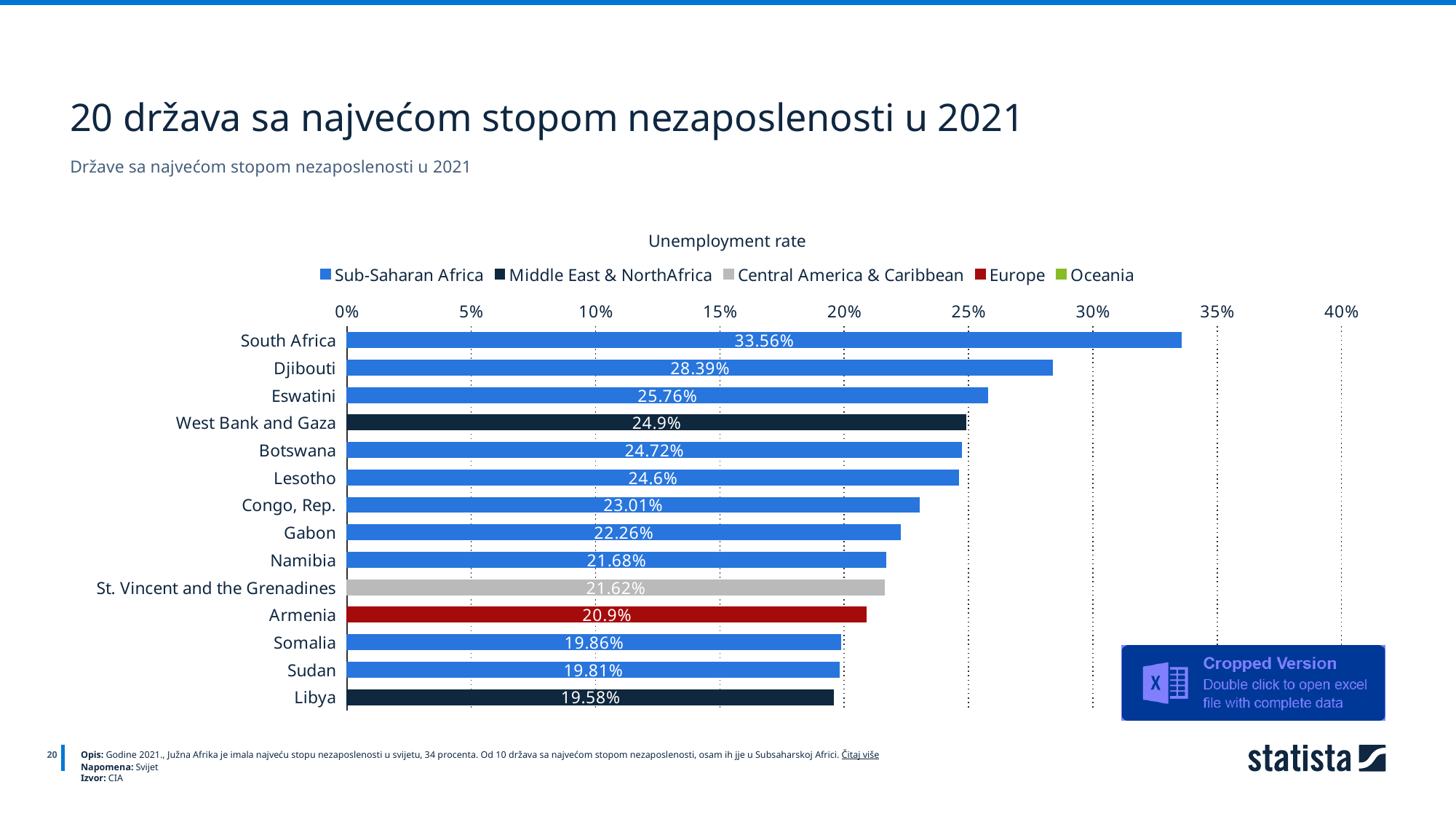
Which legend entry is shown in red? Europe How many countries are plotted on the chart? 14 Which has a higher unemployment rate, Eswatini or West Bank and Gaza? Eswatini What is the unemployment rate shown for West Bank and Gaza? 24.9% How many series does the legend list? 5 Which country has the lowest unemployment rate on the chart? Libya What is the unemployment rate shown for South Africa? 33.56% What is the unemployment rate shown for St. Vincent and the Grenadines? 21.62% Which country has the highest unemployment rate on the chart? South Africa Is the value for Gabon greater or less than 20%? greater What kind of chart is shown on the slide? Bar chart What is the difference in percentage points between the unemployment rates of South Africa and Djibouti? 5.17